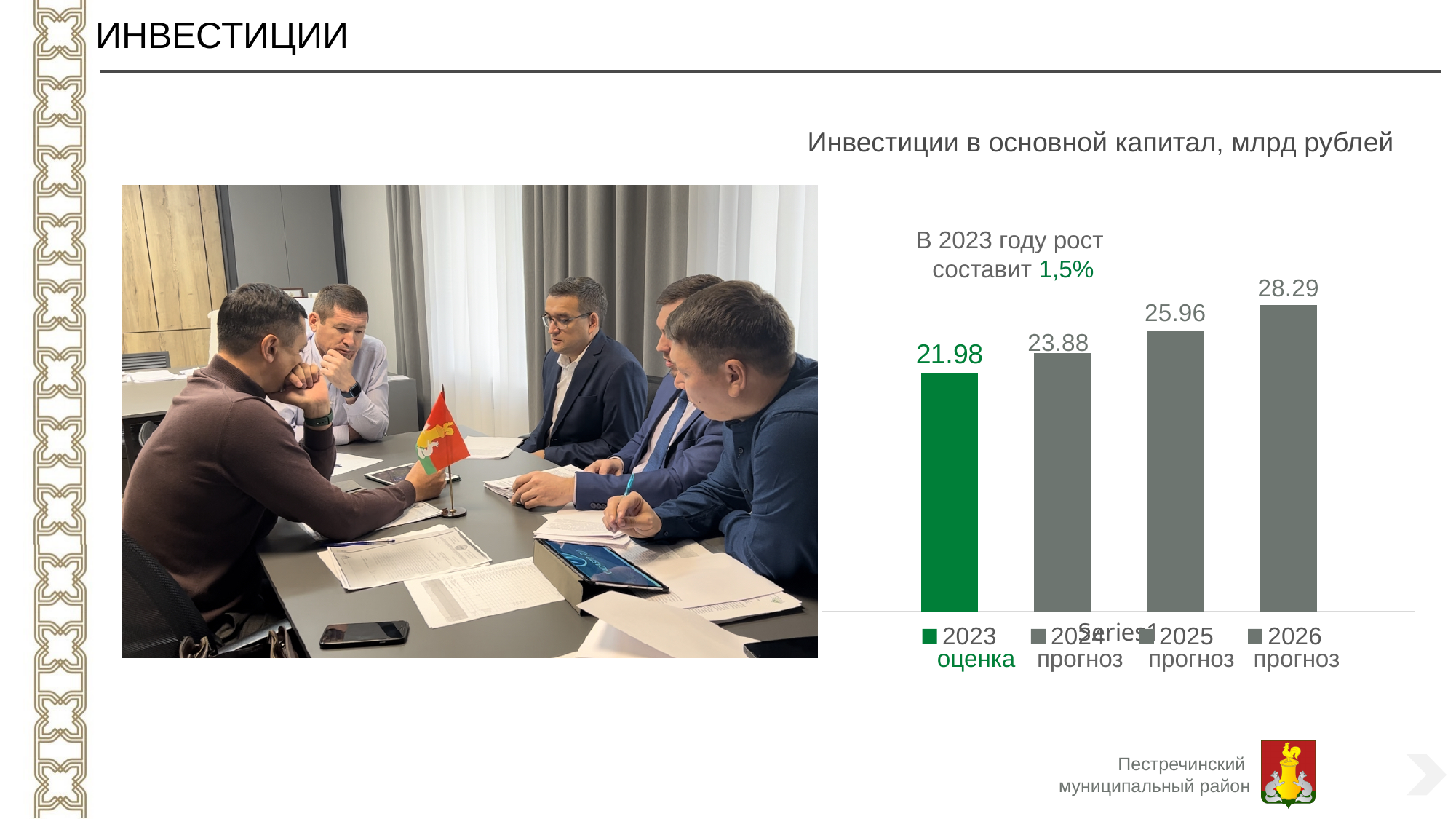
Which year has the lowest value in the chart? 2023 What is the value for 2025 (прогноз) in the chart? 25.96 What is the value for 2026 (прогноз) in the chart? 28.29 What kind of chart is shown on the slide? Bar chart What is the difference between the values for 2026 and 2023? 6.31 Do the values rise or fall from 2023 to 2026? Rise Which year has the highest value in the chart? 2026 How many bars are shown in the chart? 4 What is the value for 2023 (оценка) in the chart? 21.98 What is the difference between the values for 2025 and 2024? 2.08 Which is larger, the value for 2024 or the value for 2025? 2025 What is the value for 2024 (прогноз) in the chart? 23.88